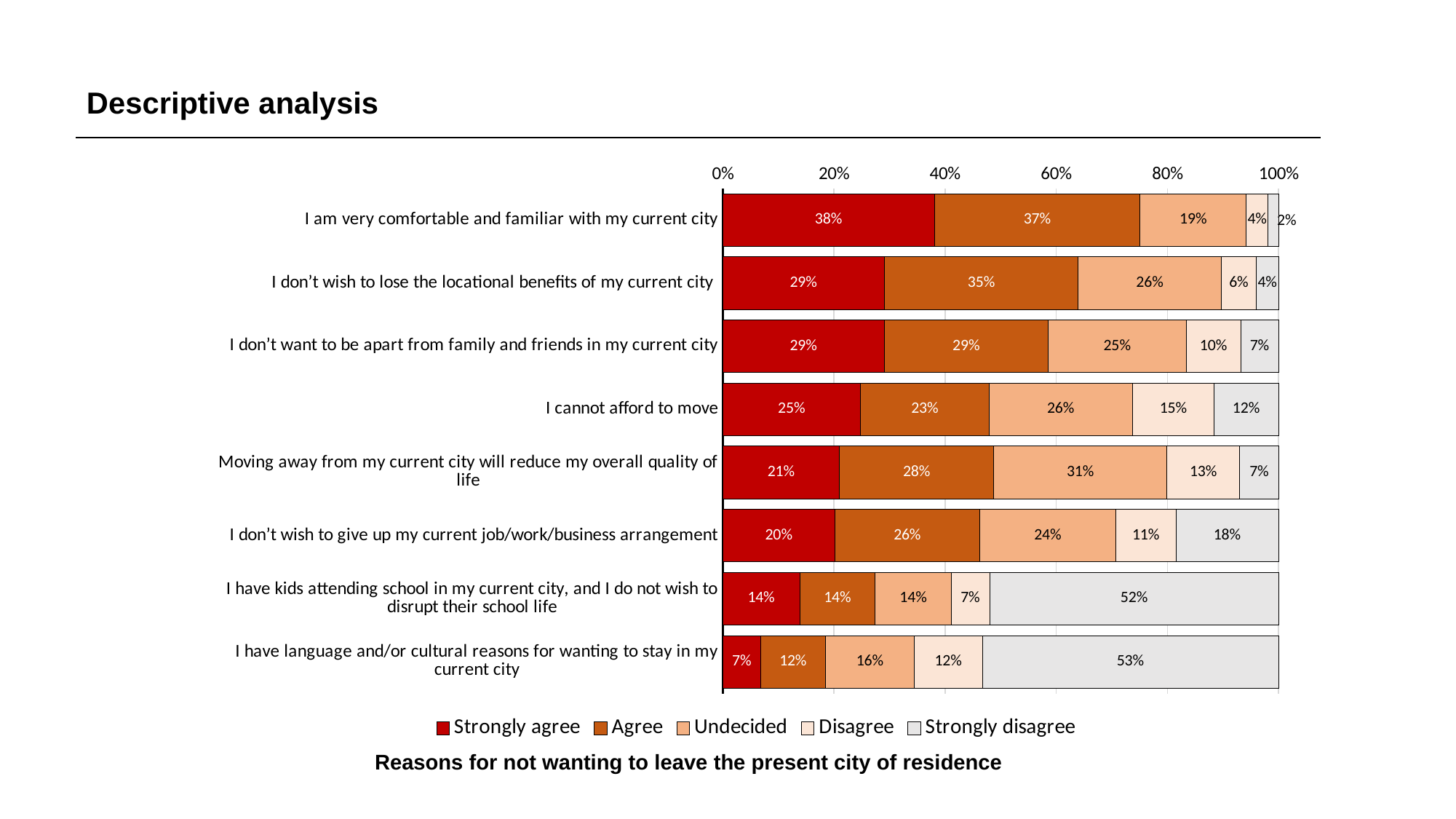
How many series does the legend list? 5 Which has the larger Undecided value: "Moving away from my current city will reduce my overall quality of life" or "I cannot afford to move"? Moving away from my current city will reduce my overall quality of life Which reason has the highest Strongly agree value? I am very comfortable and familiar with my current city Which reason has the lowest Strongly agree value? I have language and/or cultural reasons for wanting to stay in my current city What is the Disagree value for "I don't wish to give up my current job/work/business arrangement"? 11% How many reasons (categories) are plotted in the chart? 8 What is the Strongly agree value for "I cannot afford to move"? 25% For "I don't wish to lose the locational benefits of my current city", how much larger is the Agree value than the Strongly agree value? 6 percentage points What is the Strongly disagree value for "I have language and/or cultural reasons for wanting to stay in my current city"? 53% What is the combined Strongly agree and Agree value for "I am very comfortable and familiar with my current city"? 75% What is the title shown below the chart? Reasons for not wanting to leave the present city of residence What kind of chart is shown on the slide? Stacked bar chart